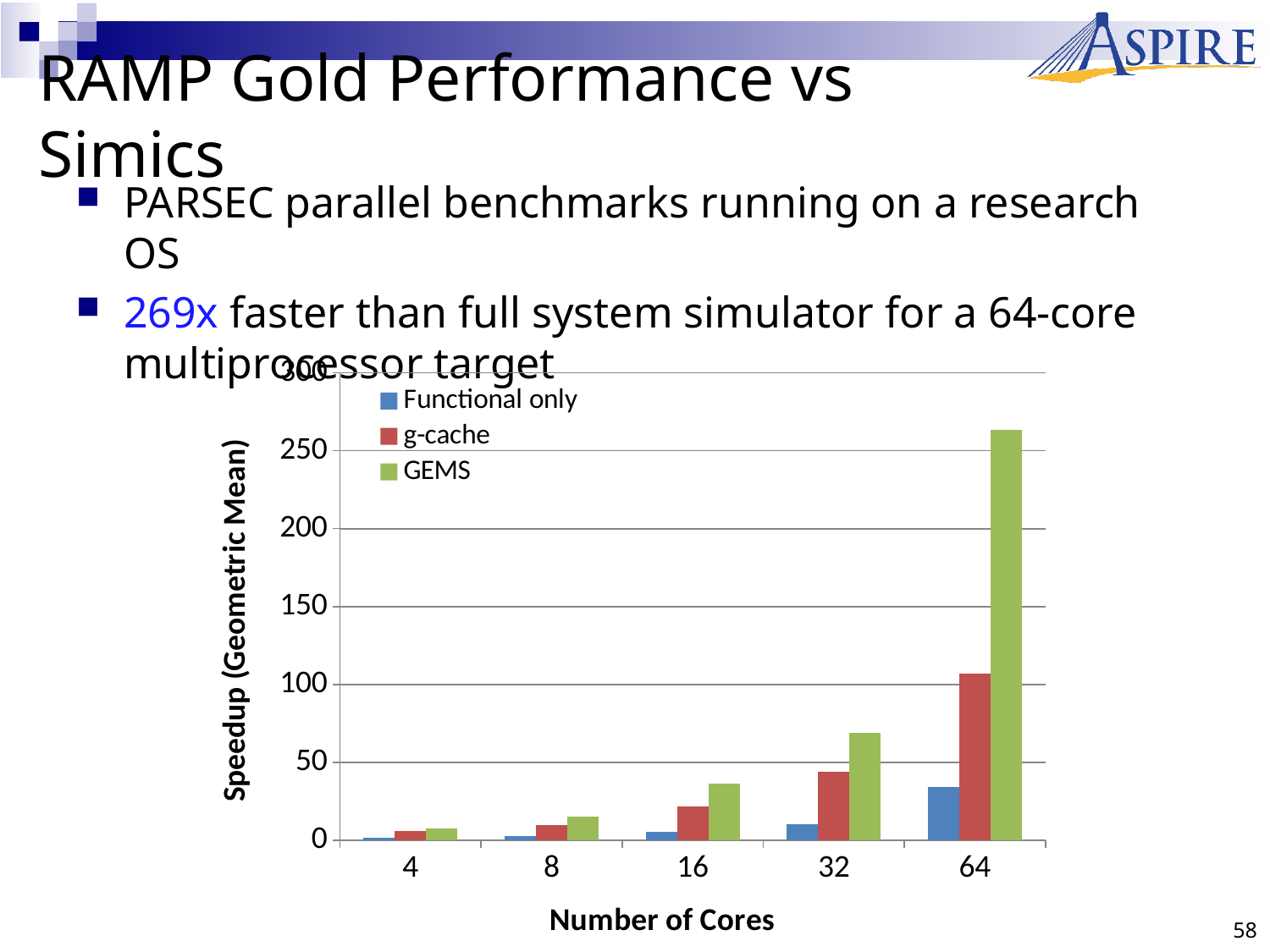
Is the GEMS speedup at 64 cores greater or less than 250? greater How many core-count categories are shown on the x axis? 5 Which series has the lowest speedup at 64 cores? Functional only Is the g-cache speedup at 64 cores greater or less than 150? less Which series has the highest speedup at 64 cores? GEMS Does the GEMS speedup rise or fall as the number of cores increases? rise Is the Functional only speedup at 64 cores greater or less than 50? less How many series does the chart legend list? 3 What is the label of the y axis? Speedup (Geometric Mean) What kind of chart is shown on the slide? bar chart Which is larger at 32 cores: the g-cache speedup or the GEMS speedup? GEMS